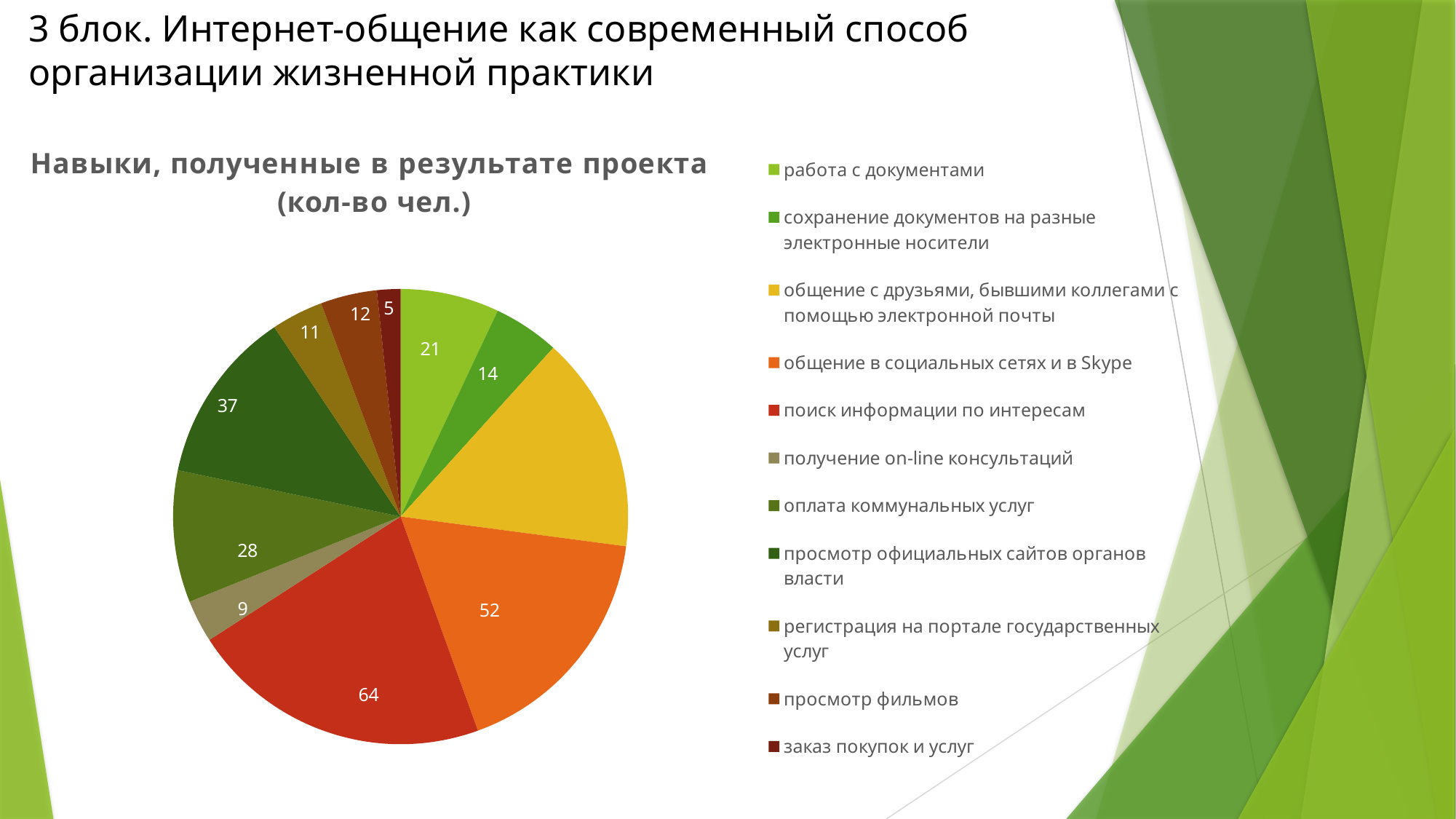
Which category has the smallest value in the pie chart? заказ покупок и услуг How many categories does the legend of the pie chart list? 11 Which is larger: the value for "оплата коммунальных услуг" or the value for "просмотр официальных сайтов органов власти"? просмотр официальных сайтов органов власти What is the value for "просмотр официальных сайтов органов власти"? 37 What is the difference between the values for "поиск информации по интересам" and "общение в социальных сетях и в Skype"? 12 What is the value for "получение on-line консультаций"? 9 Which category has the largest value in the pie chart? поиск информации по интересам What is the value for "поиск информации по интересам"? 64 What is the title of the pie chart? Навыки, полученные в результате проекта (кол-во чел.) What is the value for "общение в социальных сетях и в Skype"? 52 What is the value for "работа с документами"? 21 What kind of chart is shown on the slide? pie chart